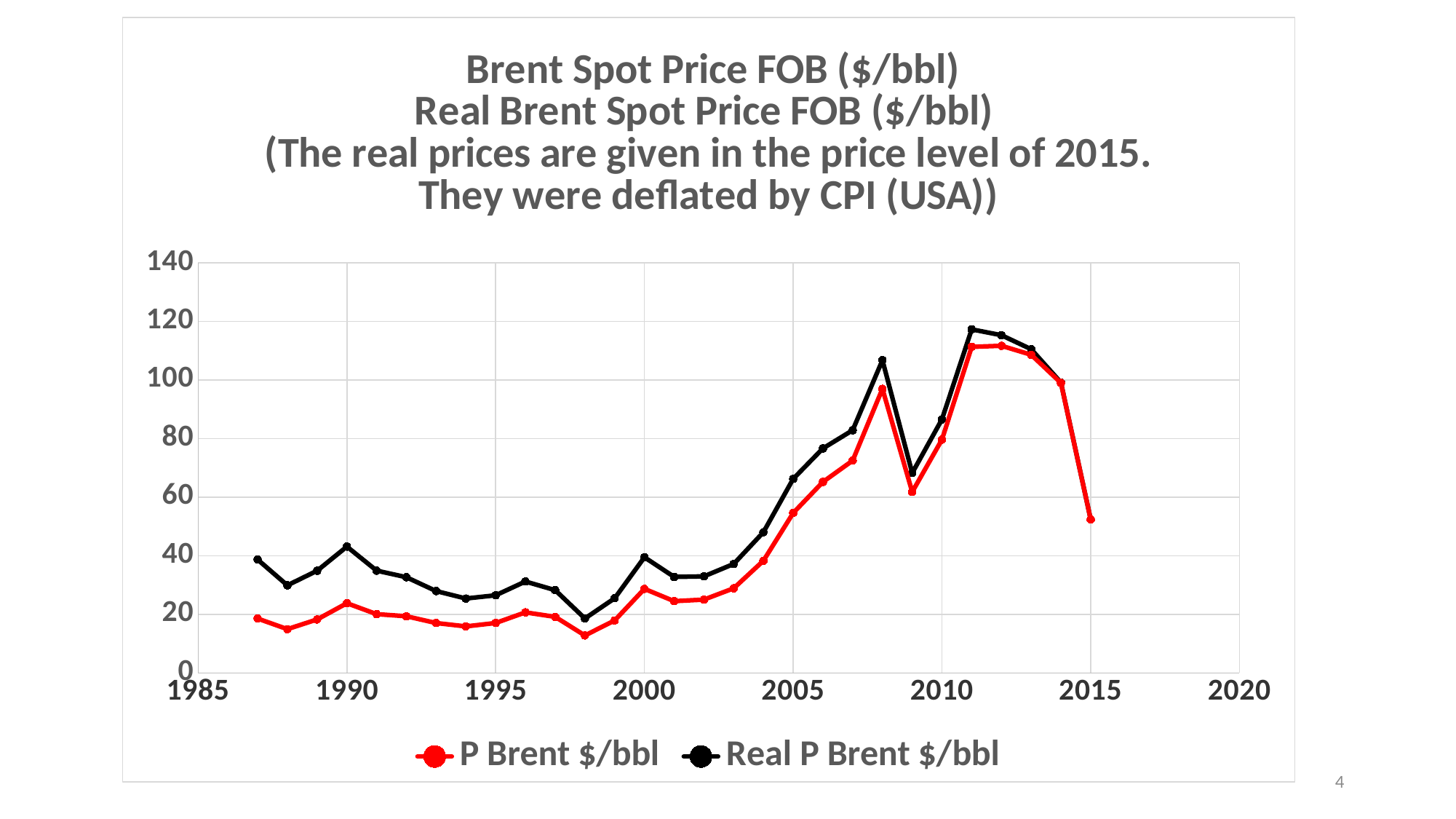
Does the P Brent $/bbl series rise or fall between 2011 and 2015? fall Is the value for Real P Brent $/bbl in 2011 greater or less than 100? greater Is the value for Real P Brent $/bbl in 2009 greater or less than 60? greater In which year does the Real P Brent $/bbl series reach its lowest value? 1998 Is the value for P Brent $/bbl in 1998 greater or less than 20? less How many series does the legend list? 2 In which year does the P Brent $/bbl series reach its lowest value? 1998 In 2008, which series has the higher value, P Brent $/bbl or Real P Brent $/bbl? Real P Brent $/bbl What kind of chart is shown on the slide? line chart In which year does the Real P Brent $/bbl series reach its highest value? 2011 Which colour is used for the Real P Brent $/bbl series? black